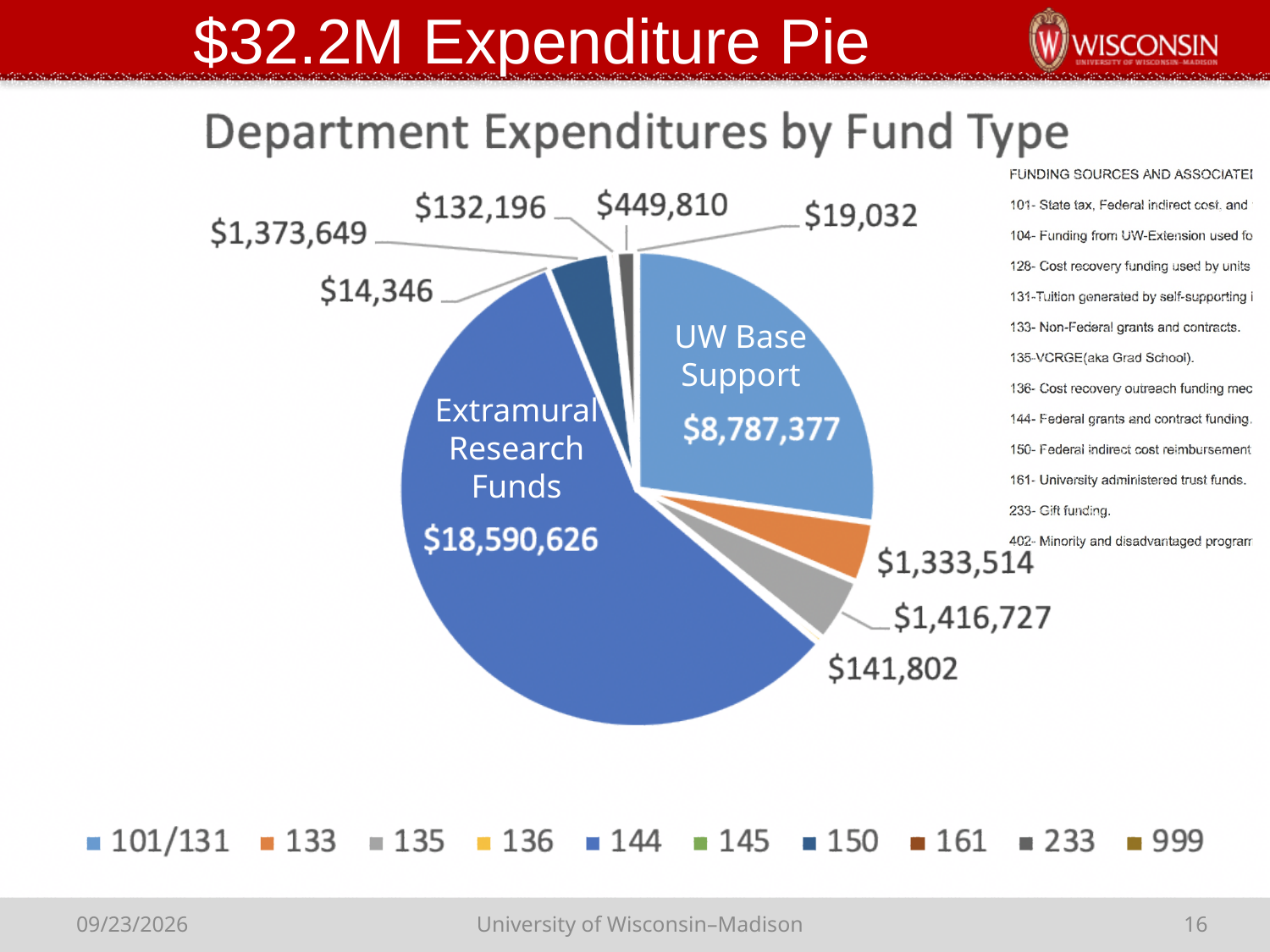
How many entries does the legend list? 10 What is the title of the chart? Department Expenditures by Fund Type What is the value of the UW Base Support slice? $8,787,377 What is the first entry listed in the legend? 101/131 What type of chart is shown on the slide? Pie chart What is the difference between the Extramural Research Funds slice and the UW Base Support slice? $9,803,249 How many data value labels are shown on the pie chart? 10 Is the UW Base Support slice larger or smaller than the Extramural Research Funds slice? Smaller What is the difference between the slice labeled $1,416,727 and the slice labeled $1,333,514? $83,213 What is the smallest value labeled on the pie chart? $14,346 Which slice of the pie is the largest? Extramural Research Funds ($18,590,626) What is the value of the Extramural Research Funds slice? $18,590,626